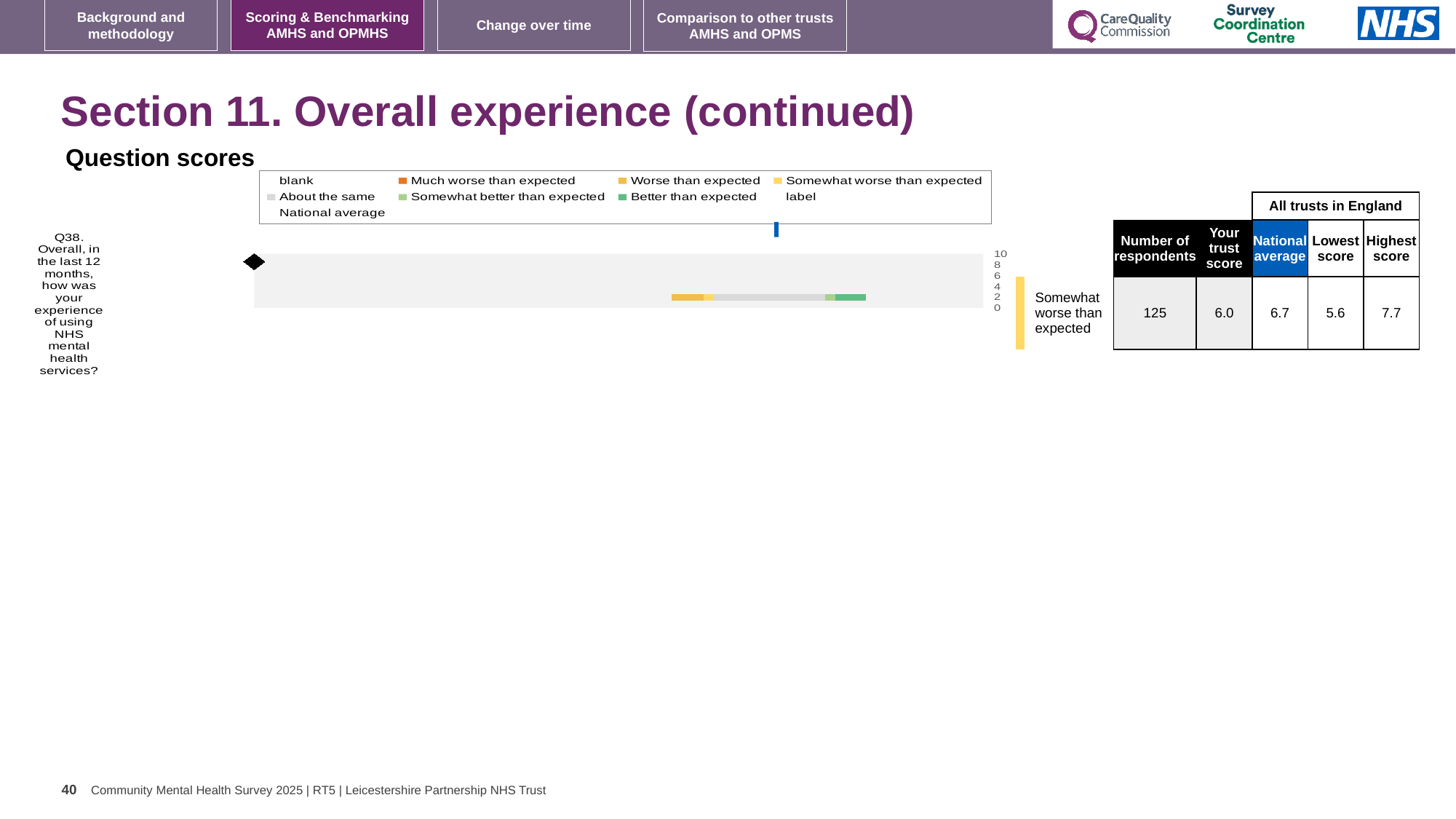
How many survey questions are plotted in the Question scores chart? 1 What is the trust score for Q38? 6.0 How many respondents are listed for Q38? 125 What is the difference between the highest score and the lowest score for Q38? 2.1 How much lower is the trust score than the national average for Q38? 0.7 What rating category is shown next to the Q38 bar? Somewhat worse than expected For Q38, which is larger: the trust score or the national average? National average What is the national average for Q38? 6.7 What is the highest score among all trusts in England for Q38? 7.7 Which question number is plotted in the Question scores chart? Q38 What is the lowest score among all trusts in England for Q38? 5.6 What type of chart is shown under 'Question scores'? bar chart